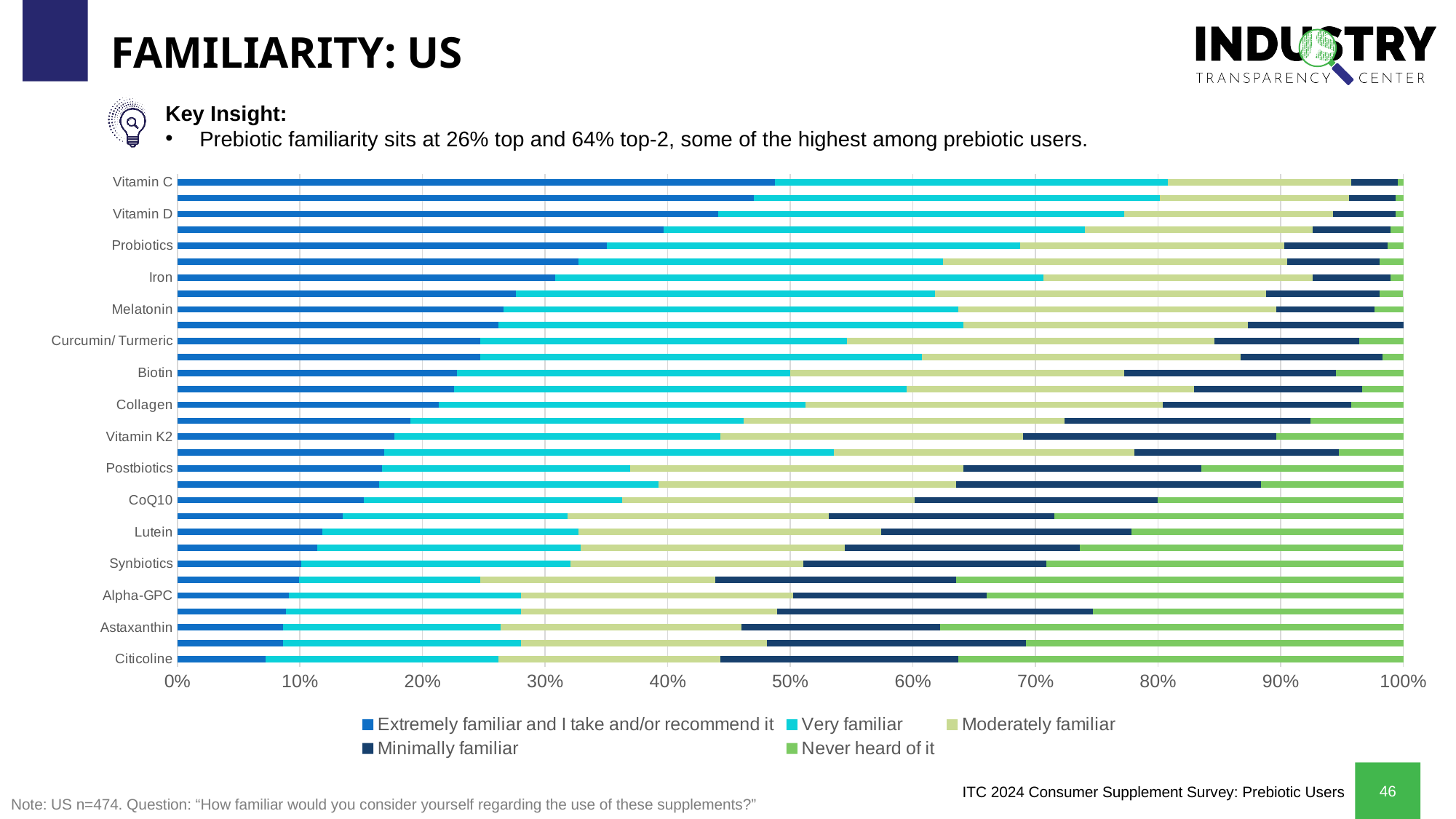
Which supplement has the longest 'Extremely familiar and I take and/or recommend it' segment? Vitamin C Is the 'Extremely familiar and I take and/or recommend it' value for Probiotics greater or less than 30%? greater What is the title of the slide? FAMILIARITY: US Is the 'Extremely familiar and I take and/or recommend it' value for Citicoline greater or less than 10%? less How many series does the legend list? 5 Is the 'Never heard of it' value for Citicoline greater or less than 30%? greater Which supplement has the shortest 'Extremely familiar and I take and/or recommend it' segment? Citicoline Which series is shown in the darkest blue segment at the left of each bar? Extremely familiar and I take and/or recommend it What kind of chart is shown on the slide? Stacked bar chart Which has a larger 'Extremely familiar and I take and/or recommend it' share, Probiotics or Iron? Probiotics Moving from the top bar (Vitamin C) down to the bottom bar (Citicoline), does the 'Extremely familiar and I take and/or recommend it' segment get longer or shorter? Shorter Which supplement has the largest 'Never heard of it' segment? Astaxanthin